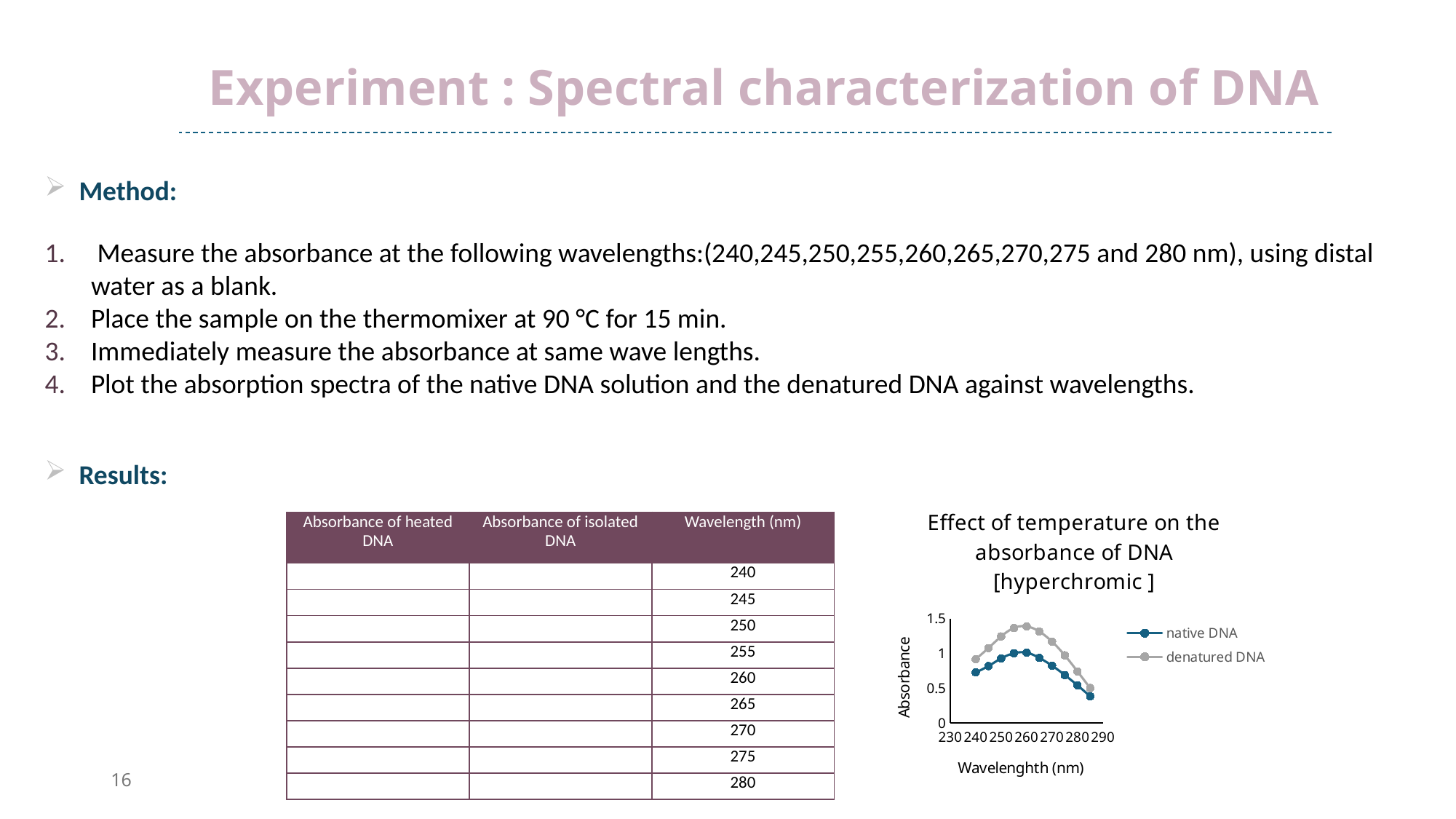
How many series does the chart's legend list? 2 Is the absorbance of native DNA at 260 nm greater or less than 0.5? greater What is the title of the chart? Effect of temperature on the absorbance of DNA [hyperchromic ] How many data points are plotted for the native DNA series? 10 Is the absorbance of denatured DNA at 240 nm greater or less than 0.5? greater What are the two series named in the chart's legend? native DNA and denatured DNA Is the absorbance of denatured DNA at 260 nm greater or less than 1? greater At which wavelength does the denatured DNA series reach its highest absorbance? 260 Between 260 nm and 280 nm, does the absorbance of native DNA rise or fall? fall What kind of chart is shown on the slide? line chart At 260 nm, which series has the higher absorbance, native DNA or denatured DNA? denatured DNA